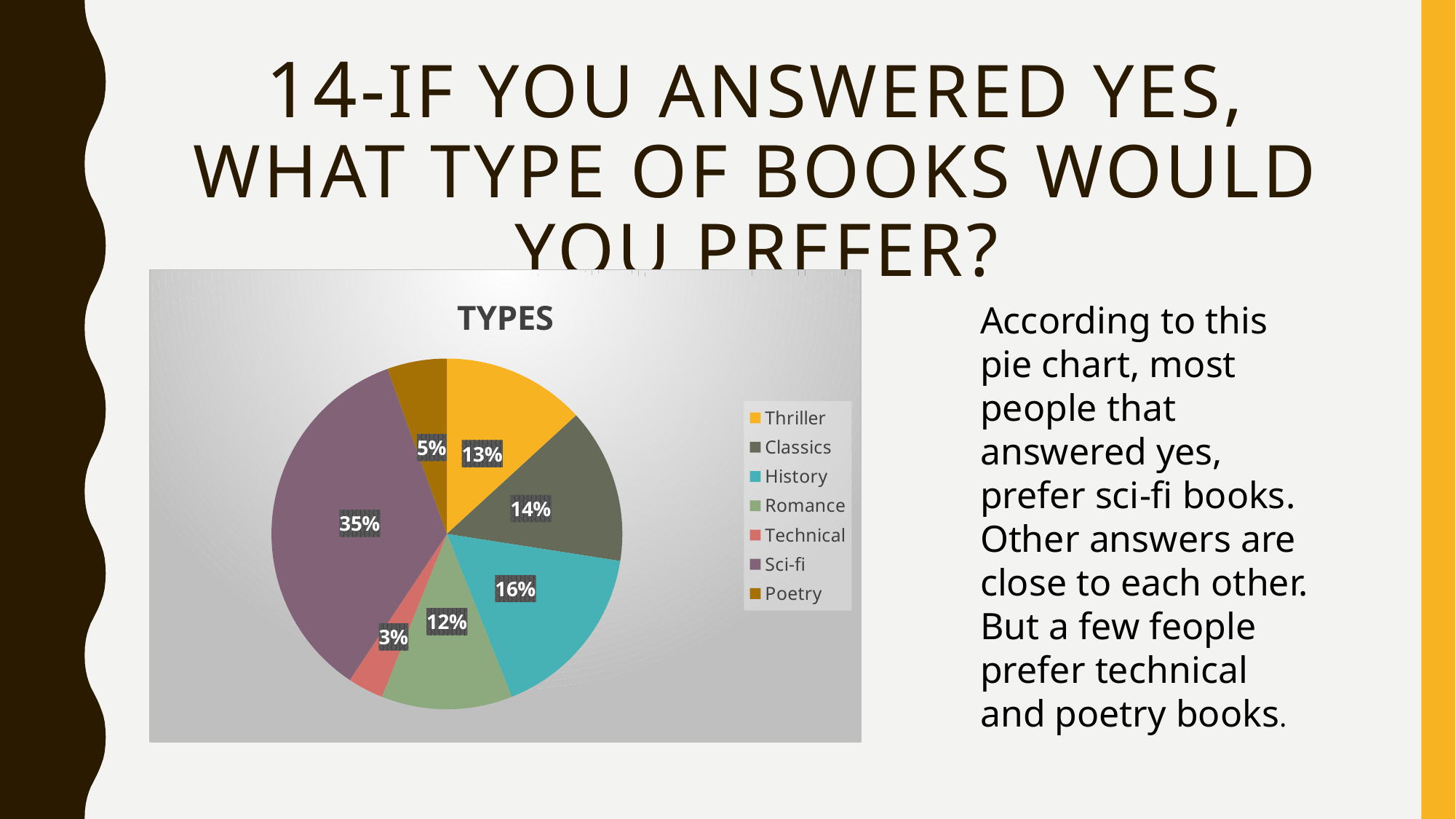
Which has a larger share, Thriller or Romance? Thriller Which book type has the largest share of the pie? Sci-fi Which book type has the smallest share of the pie? Technical What is the title of the chart? TYPES What colour is the Sci-fi slice in the pie chart? purple What percentage of the pie is History? 16% What percentage of the pie is Poetry? 5% What percentage of the pie is Technical? 3% What is the difference in percentage points between Sci-fi and Classics? 21 What percentage of the pie is Sci-fi? 35% What type of chart is shown on the slide? pie chart How many book types are shown in the pie chart? 7